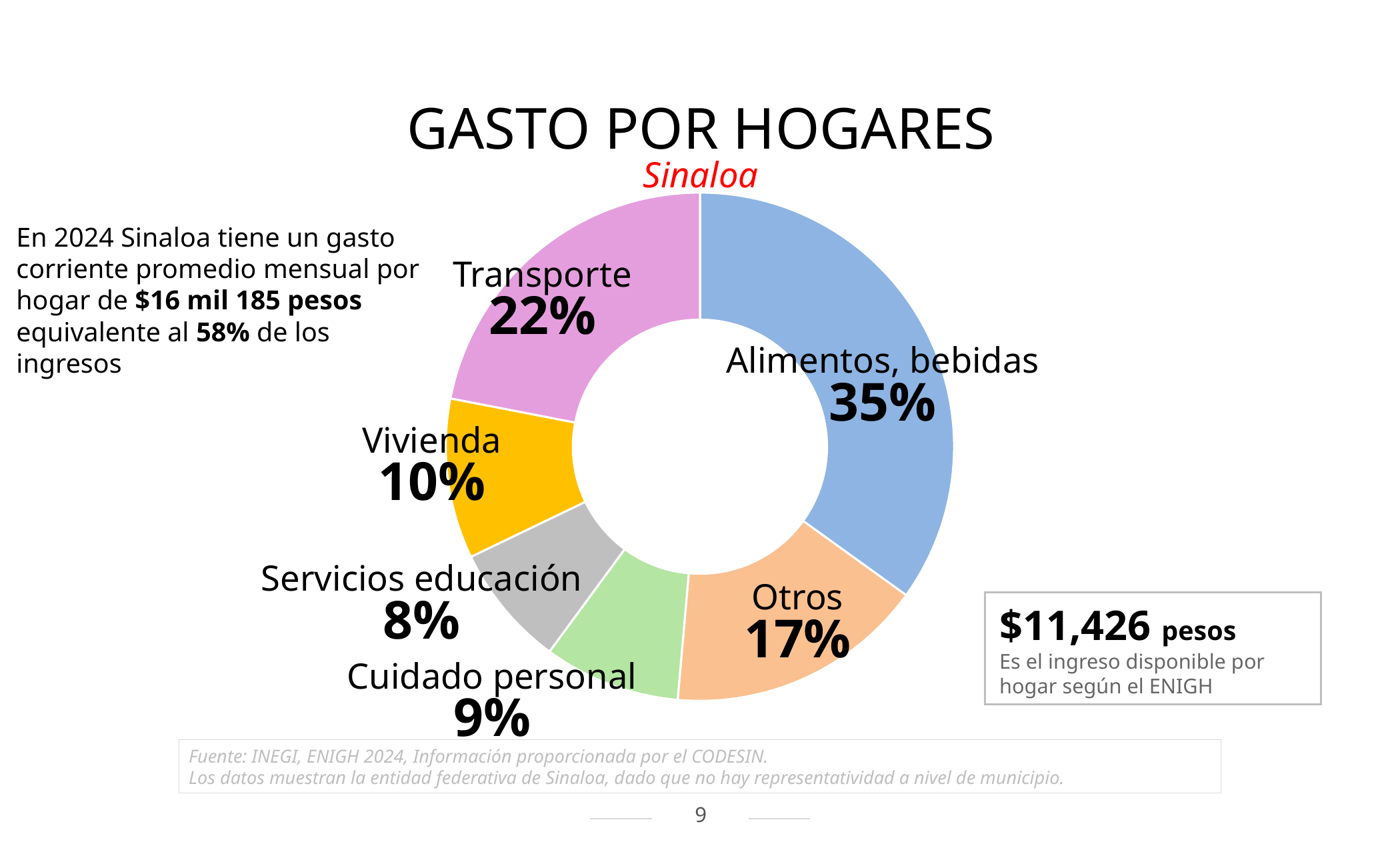
Which category has the smallest share of the chart? Servicios educación Which is larger, Otros or Vivienda? Otros What percentage is shown for Servicios educación? 8% What colour is the Vivienda slice? Yellow What is the difference in percentage points between Alimentos, bebidas and Transporte? 13 What is the value for Vivienda? 10% What share of household spending goes to Alimentos, bebidas? 35% What percentage is shown for Transporte? 22% Which category has the largest share of the chart? Alimentos, bebidas How many categories are shown in the chart? 6 What kind of chart is shown on the slide? Pie chart (donut) What is the title of the chart? GASTO POR HOGARES